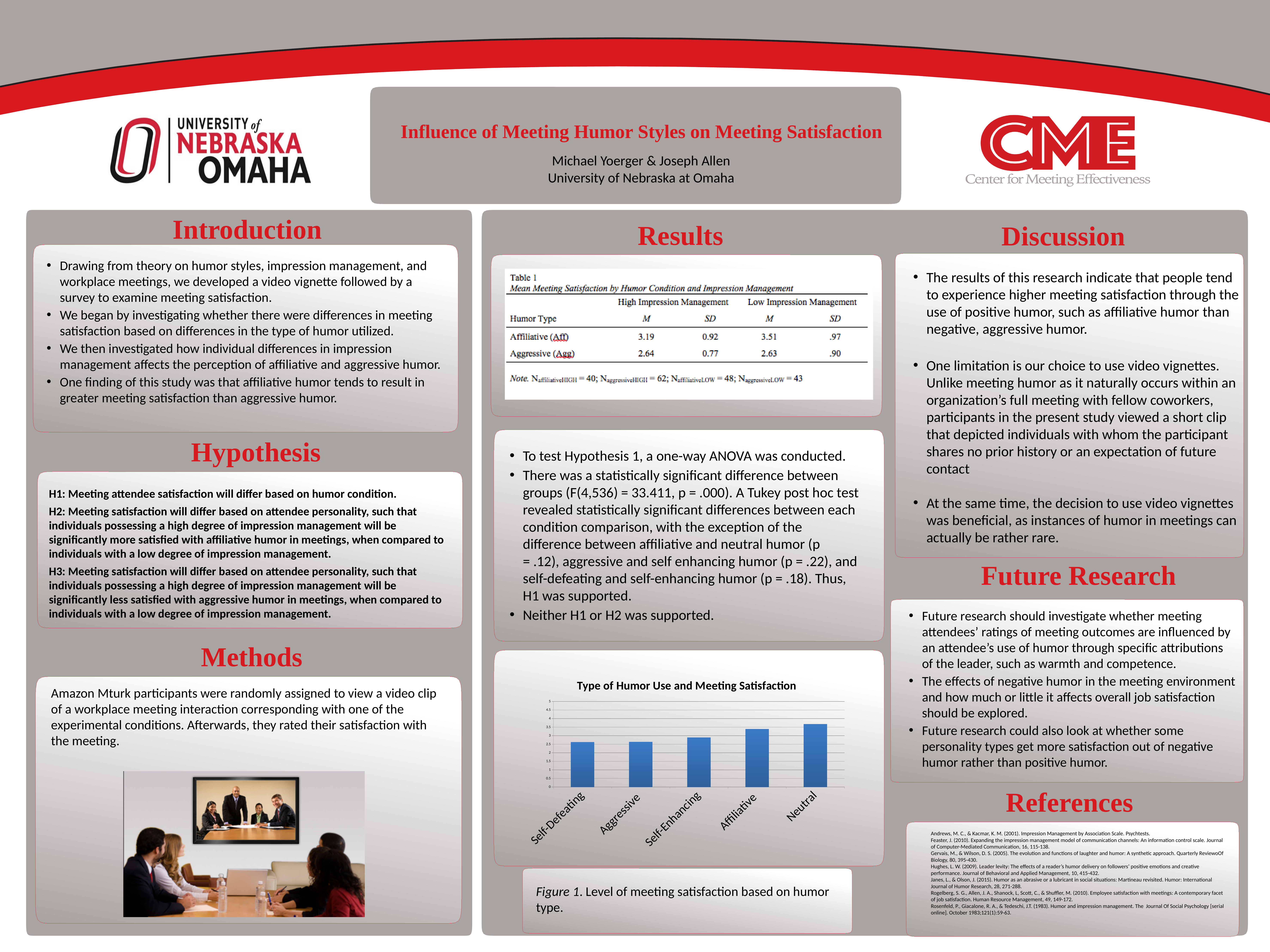
Do the bars in the "Type of Humor Use and Meeting Satisfaction" chart generally rise or fall from left to right? rise In the "Type of Humor Use and Meeting Satisfaction" chart, is the value for Aggressive greater or less than 3? less What is the title of the bar chart in the Results section? Type of Humor Use and Meeting Satisfaction In the "Type of Humor Use and Meeting Satisfaction" chart, is the value for Self-Enhancing greater or less than 2.5? greater In the "Type of Humor Use and Meeting Satisfaction" chart, is the value for Affiliative greater or less than 3? greater How many humor types are plotted in the "Type of Humor Use and Meeting Satisfaction" chart? 5 In the "Type of Humor Use and Meeting Satisfaction" chart, which is larger: Neutral or Self-Defeating? Neutral What kind of chart is shown under the title "Type of Humor Use and Meeting Satisfaction"? bar chart In the "Type of Humor Use and Meeting Satisfaction" chart, which is larger: Affiliative or Aggressive? Affiliative Which humor type has the highest meeting satisfaction in the "Type of Humor Use and Meeting Satisfaction" chart? Neutral